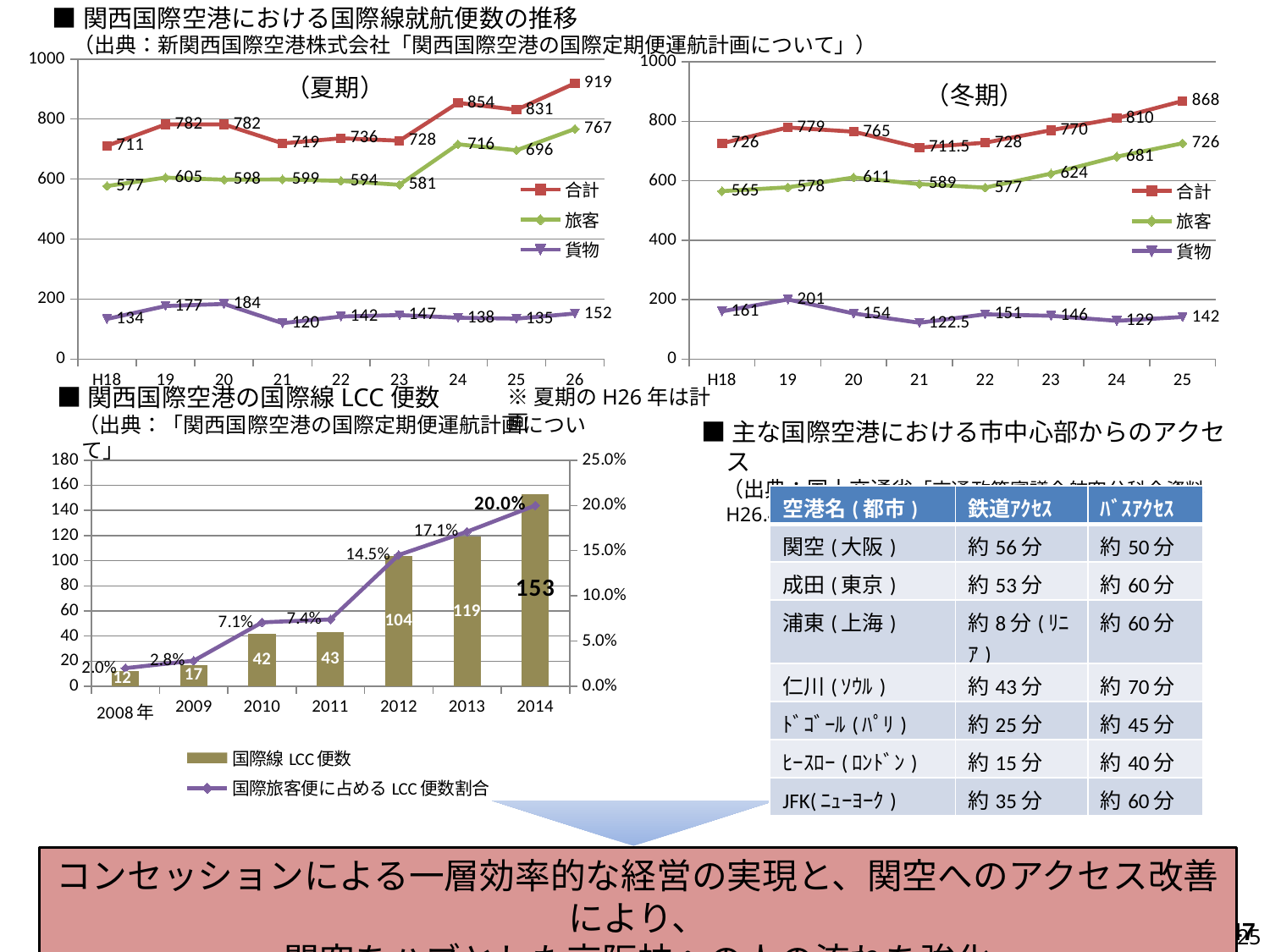
In the summer (夏期) chart, what is the 合計 value for H26? 919 In the winter (冬期) chart, in which year is the 旅客 value lowest? H18 In the LCC chart (関西国際空港の国際線LCC便数), what is the 国際線LCC便数 value for 2014? 153 In the summer (夏期) chart, in which year is the 貨物 value highest? 20 In the winter (冬期) chart, what is the 合計 value for year 21? 711.5 In the summer (夏期) chart, what is the difference between the 合計 values for H26 and H18? 208 In the LCC chart (関西国際空港の国際線LCC便数), what is the difference in 国際線LCC便数 between 2014 and 2013? 34 In the LCC chart (関西国際空港の国際線LCC便数), how many years are shown on the x axis? 7 In the winter (冬期) chart, in which year is the 貨物 value highest? 19 How many series does the legend of the summer (夏期) chart list? 3 In the LCC chart (関西国際空港の国際線LCC便数), what is the 国際旅客便に占めるLCC便数割合 for 2012? 14.5% In the winter (冬期) chart, does the 合計 value rise or fall from year 21 to year 25? rise